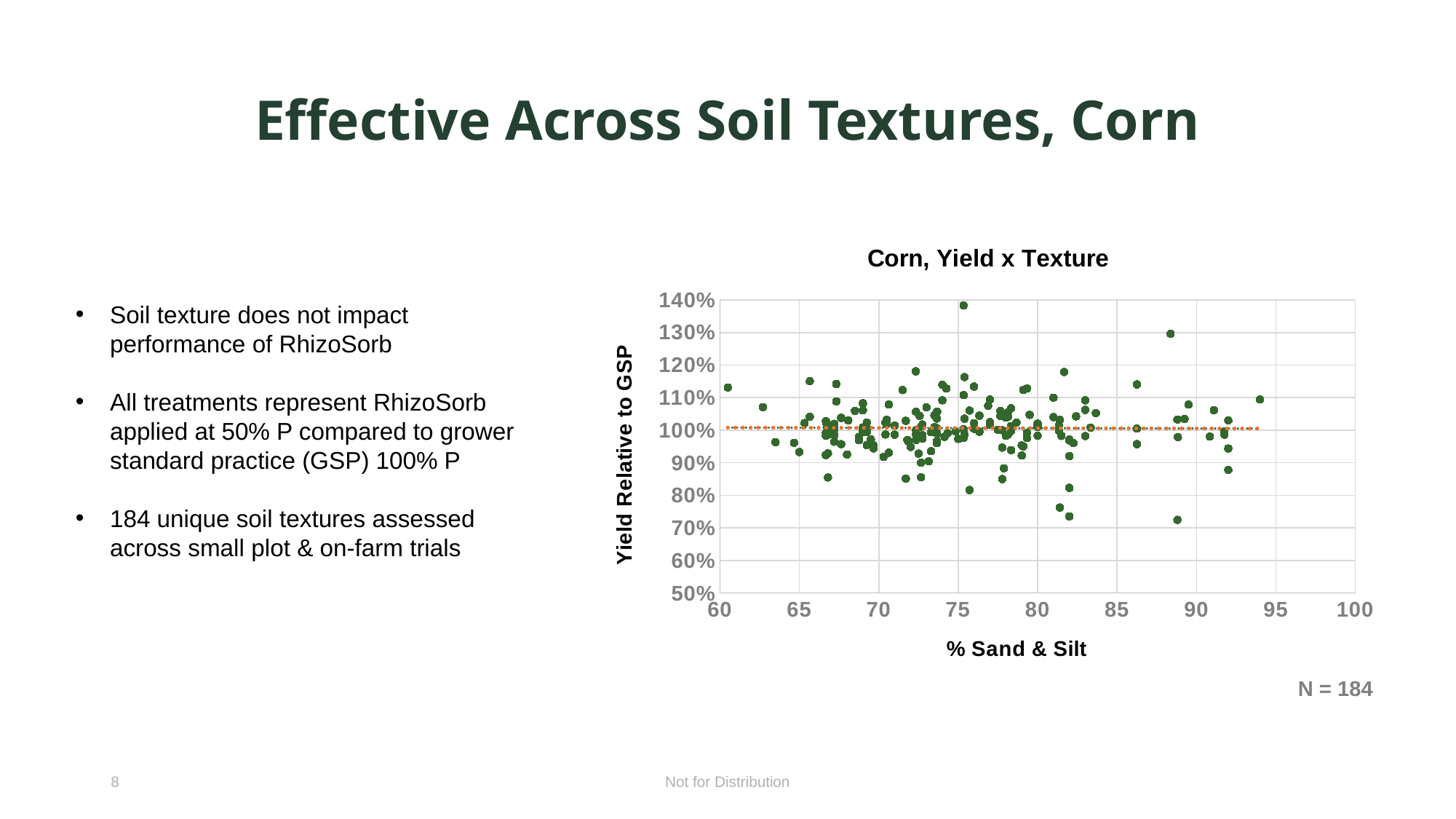
Does the dotted trend line in the chart rise, fall, or stay flat as % Sand & Silt increases? stays flat Is the dotted trend line in the chart greater or less than 90% on the y axis? greater What kind of chart is shown on the slide? scatter chart Is the lowest plotted point in the chart greater or less than 80%? less What is the label of the x axis of the chart? % Sand & Silt Is the dotted trend line in the chart greater or less than 110% on the y axis? less What is the title of the chart? Corn, Yield x Texture How many data points are plotted in the chart, according to the N value shown on the slide? 184